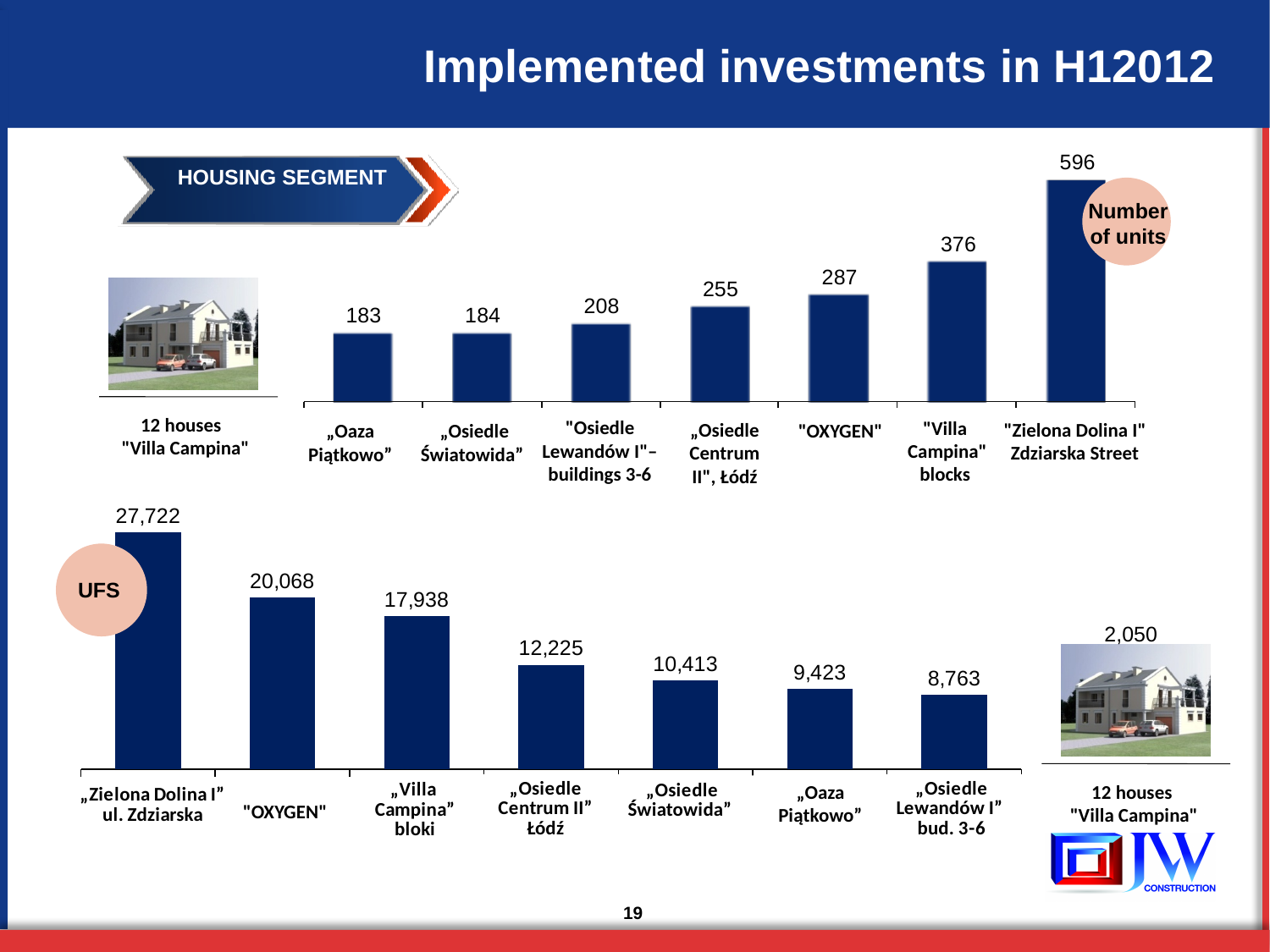
In the top 'Number of units' chart, how many bars are plotted? 7 In the bottom 'UFS' chart, what is the difference between „Osiedle Światowida” and „Oaza Piątkowo”? 990 In the bottom 'UFS' chart, what is the value for „Osiedle Centrum II” Łódź? 12,225 In the top 'Number of units' chart, which category has the lowest value? „Oaza Piątkowo” In the bottom 'UFS' chart, which is larger: "OXYGEN" or „Villa Campina” bloki? "OXYGEN" In the top 'Number of units' chart, which category has the highest value? "Zielona Dolina I" Zdziarska Street In the top 'Number of units' chart, what is the value for "OXYGEN"? 287 In the bottom 'UFS' chart, which bar has the lowest value? „Osiedle Lewandów I” bud. 3-6 What type of chart is used for the 'UFS' data at the bottom of the slide? bar chart In the top 'Number of units' chart, what is the difference between "Zielona Dolina I" Zdziarska Street and "Villa Campina" blocks? 220 In the bottom 'UFS' chart, which bar has the highest value? „Zielona Dolina I” ul. Zdziarska In the top 'Number of units' chart, do the values rise or fall from left to right? rise